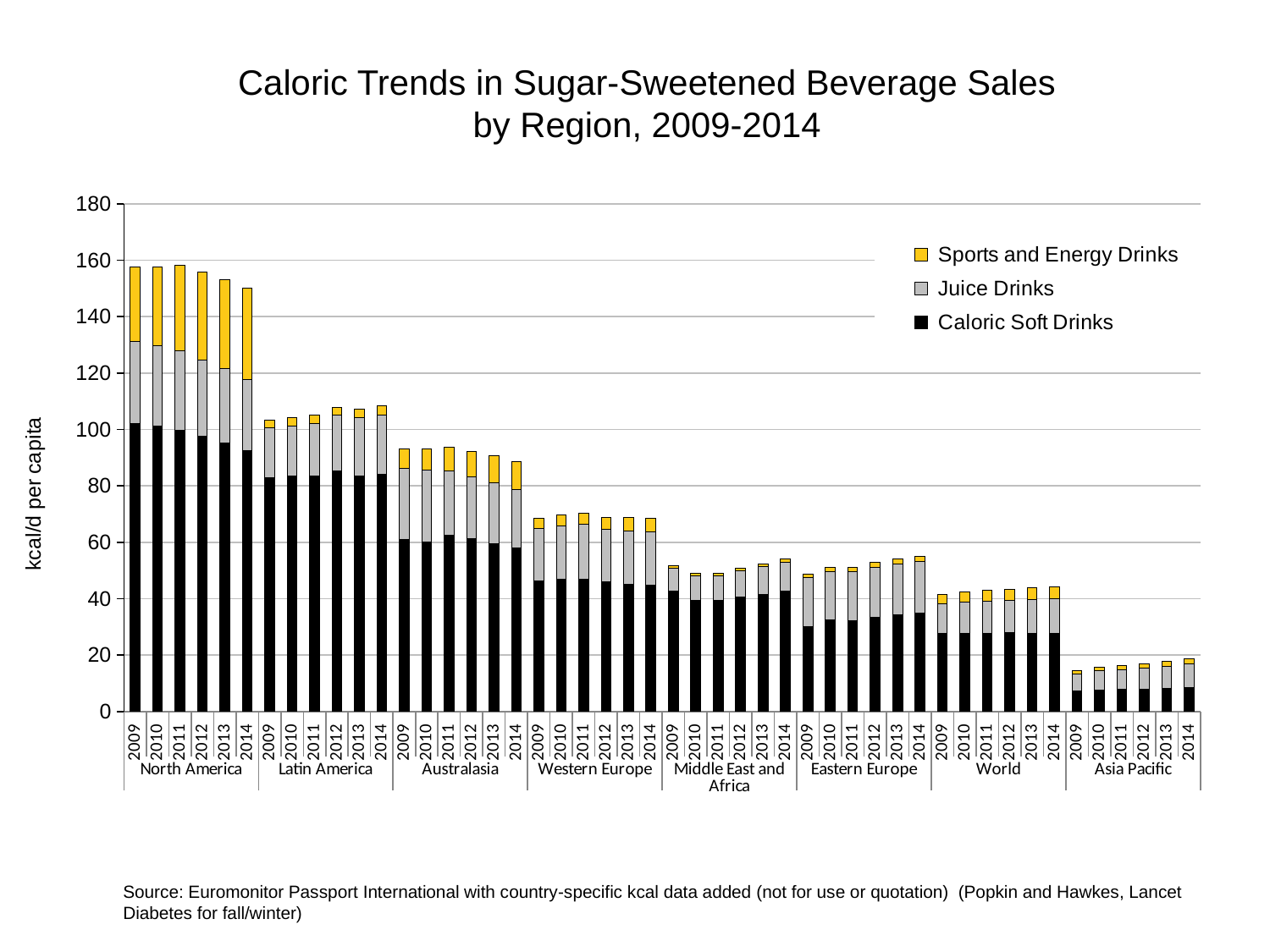
Is the total value for Asia Pacific in 2014 greater or less than 20? less How many regions are shown along the x axis? 8 How many years are plotted for each region? 6 Is the total value for Middle East and Africa in 2009 greater or less than 60? less Which colour represents Sports and Energy Drinks in the legend? Yellow Do the total values for Eastern Europe rise or fall from 2009 to 2014? rise Do the total values for North America rise or fall from 2009 to 2014? fall Which region has the lowest total sugar-sweetened beverage calories? Asia Pacific Is the total value for North America in 2009 greater or less than 140? greater What kind of chart is shown on the slide? Stacked bar chart How many series does the legend list? 3 Which region has the highest total sugar-sweetened beverage calories? North America